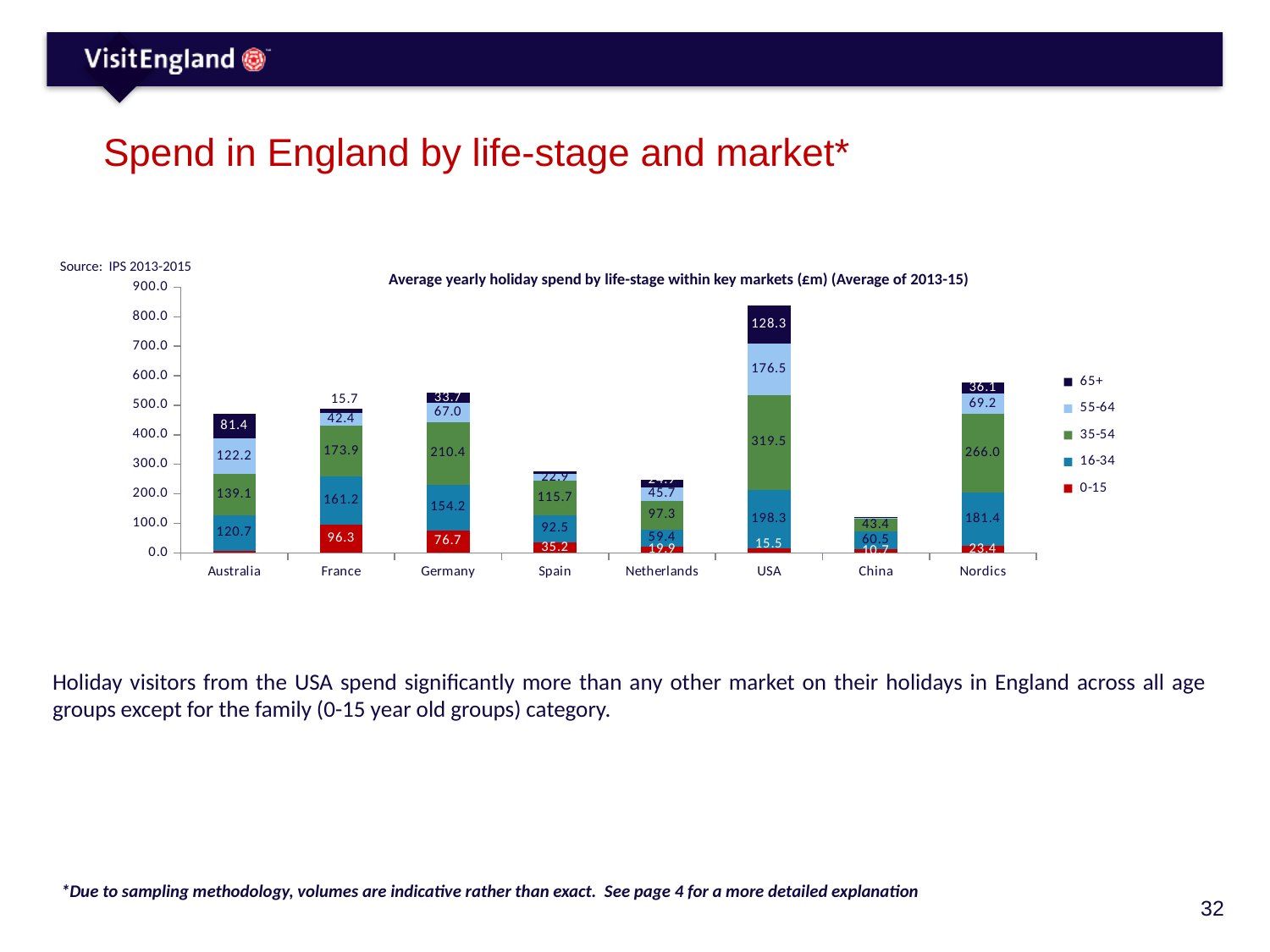
What is the difference between the 35-54 values for the USA and the Nordics? 53.5 What is the value for the 65+ segment of the Germany bar? 33.7 What kind of chart is shown on the slide? Stacked bar chart Which has the larger 0-15 value, France or Germany? France What is the value for the 0-15 segment of the France bar? 96.3 What is the value for the 16-34 segment of the Nordics bar? 181.4 How many series does the legend list? 5 Which market has the highest total stacked bar? USA Which market has the lowest total stacked bar? China How many markets are shown on the x axis? 8 What is the total of the USA stacked bar? 838.1 What is the value for the 35-54 segment of the USA bar? 319.5